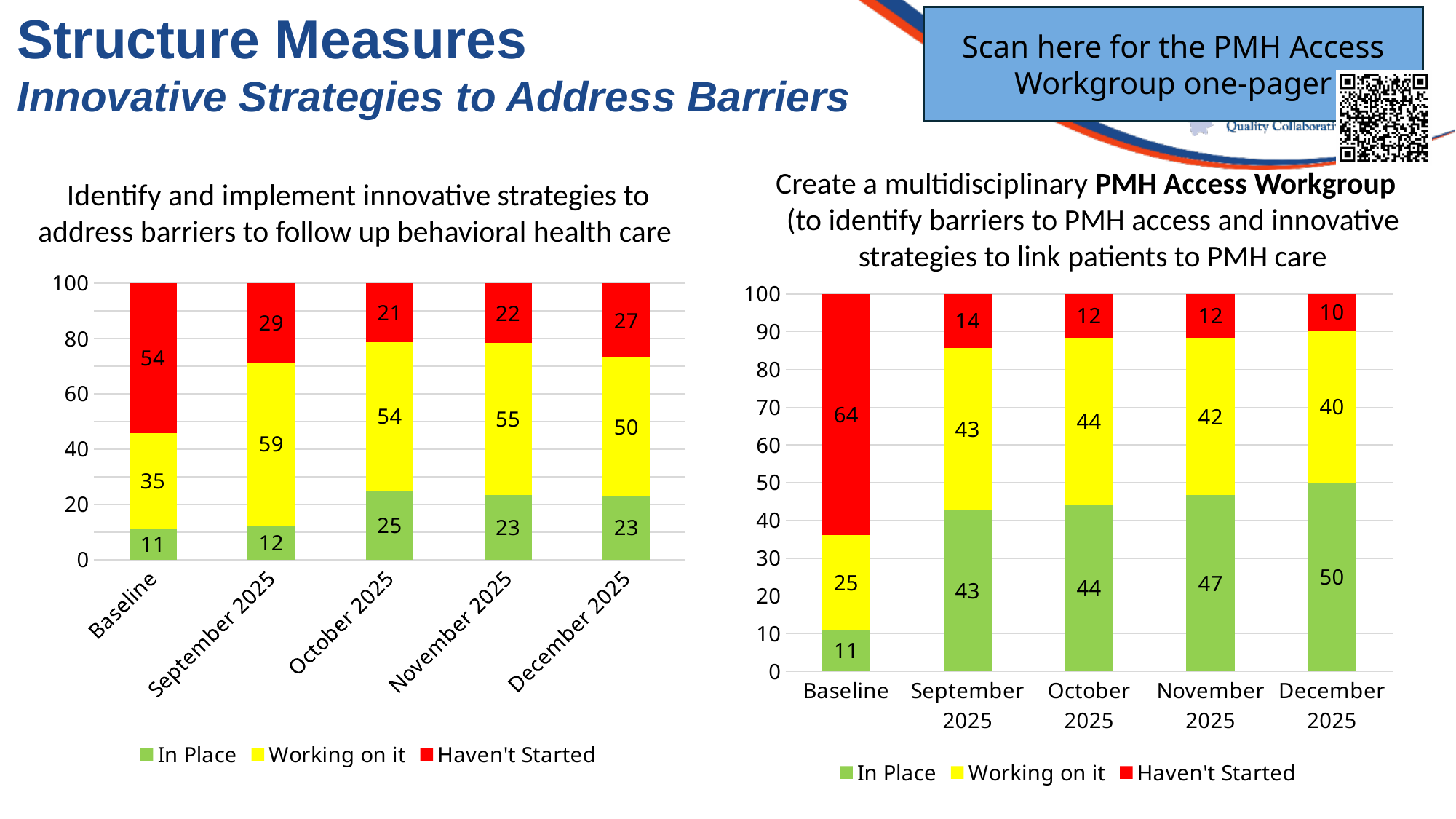
How many series does the legend of the right chart (Create a multidisciplinary PMH Access Workgroup) list? 3 In the right chart (Create a multidisciplinary PMH Access Workgroup), what is the 'Working on it' value for Baseline? 25 In the left chart (Identify and implement innovative strategies), is the 'Working on it' value larger for September 2025 or December 2025? September 2025 In the right chart (Create a multidisciplinary PMH Access Workgroup), does the 'In Place' value rise or fall from Baseline to December 2025? Rise In the left chart (Identify and implement innovative strategies), what is the 'Haven't Started' value for Baseline? 54 What kind of chart is the right chart (Create a multidisciplinary PMH Access Workgroup)? Stacked bar chart In the left chart (Identify and implement innovative strategies), which category has the lowest 'In Place' value? Baseline In the right chart (Create a multidisciplinary PMH Access Workgroup), what is the difference between the 'In Place' values for December 2025 and Baseline? 39 In the left chart (Identify and implement innovative strategies), what is the 'In Place' value for October 2025? 25 In the right chart (Create a multidisciplinary PMH Access Workgroup), what is the 'In Place' value for December 2025? 50 How many categories are shown on the x axis of the left chart (Identify and implement innovative strategies)? 5 In the right chart (Create a multidisciplinary PMH Access Workgroup), which category has the highest 'Haven't Started' value? Baseline